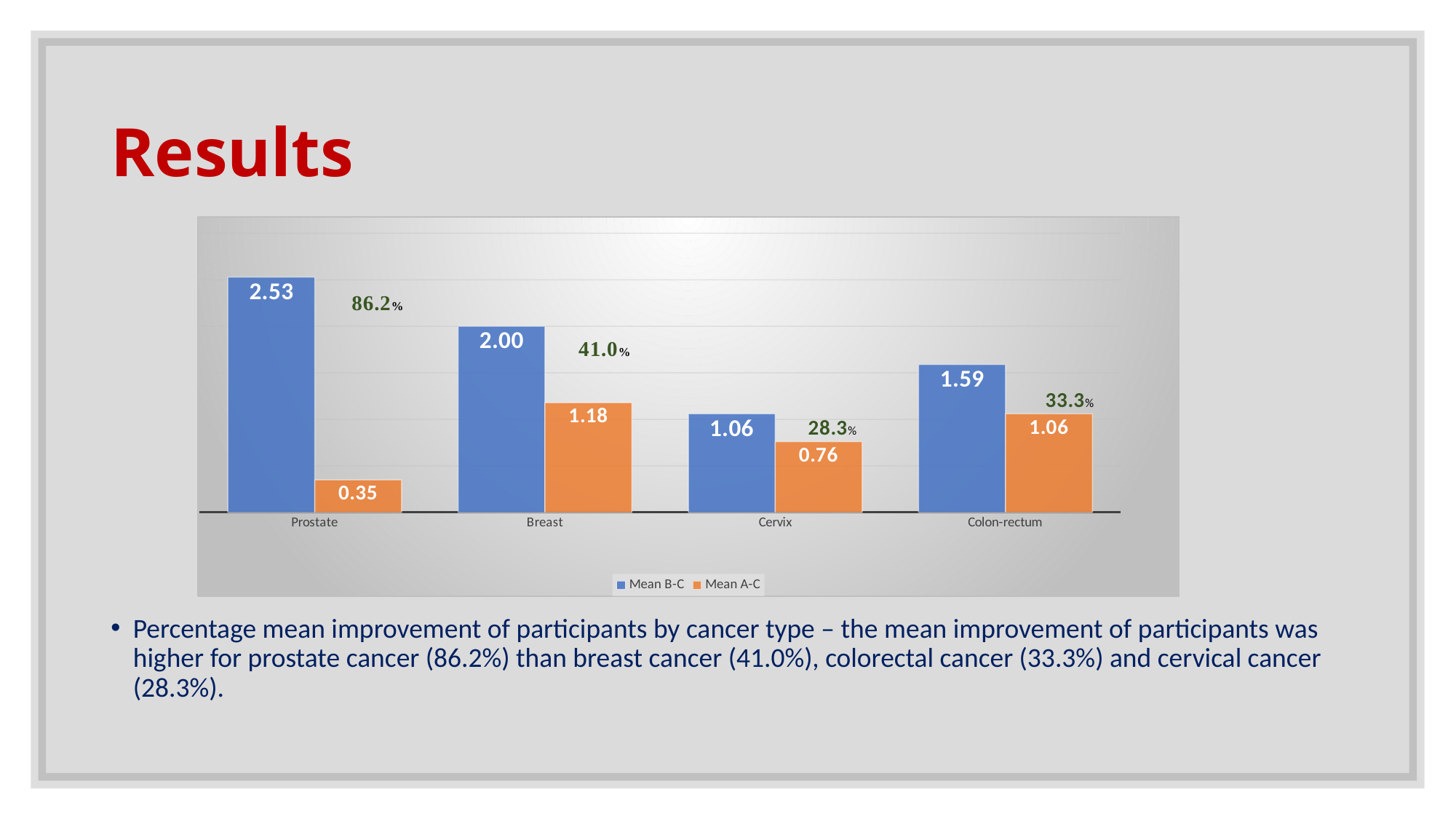
What is the Mean A-C value for Cervix? 0.76 What is the Mean B-C value for Prostate? 2.53 What is the Mean A-C value for Breast? 1.18 Which category has the lowest Mean A-C value? Prostate Which is larger for Breast: the Mean B-C value or the Mean A-C value? Mean B-C What kind of chart is shown on the slide? Bar chart What percentage improvement is annotated above the Cervix bars? 28.3% Which category has the highest Mean B-C value? Prostate What is the Mean B-C value for Colon-rectum? 1.59 What is the difference between the Mean B-C and Mean A-C values for Prostate? 2.18 How many series does the legend list? 2 How many categories are shown on the x axis? 4